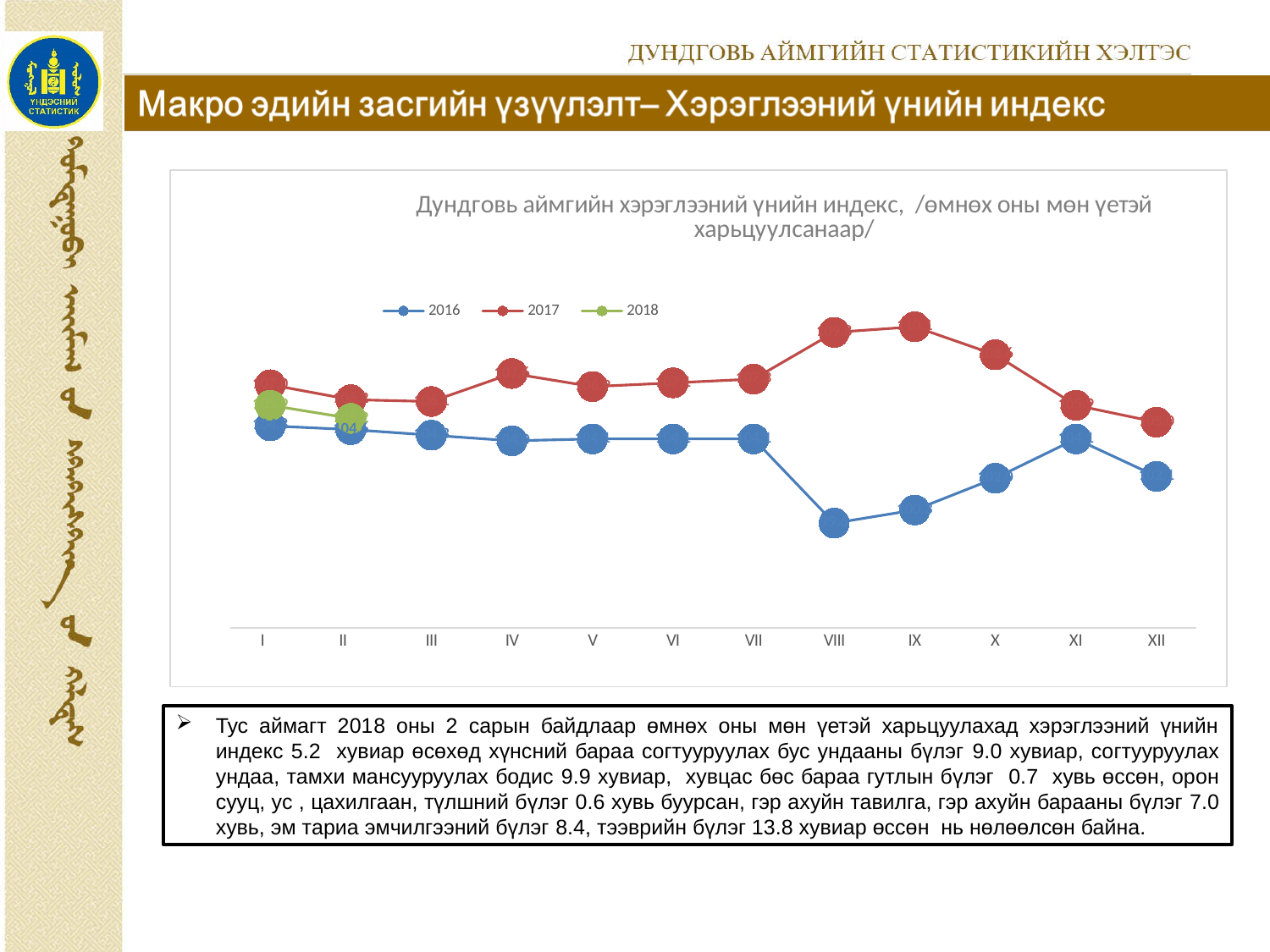
How many categories are shown on the x axis? 12 In which month is the 2016 series at its lowest? VIII In which month is the 2017 series at its lowest? XII For the 2018 series, which month has the higher value, I or II? I Does the 2017 series rise or fall from month VII to month IX? rise In which month is the 2017 series at its highest? IX How many data points does the 2018 series have? 2 How many series does the legend list? 3 Does the 2016 series rise or fall from month VII to month VIII? fall What kind of chart is shown on the slide? line chart Which years are listed in the legend? 2016, 2017, 2018 At month VIII, which series has the higher value, 2016 or 2017? 2017